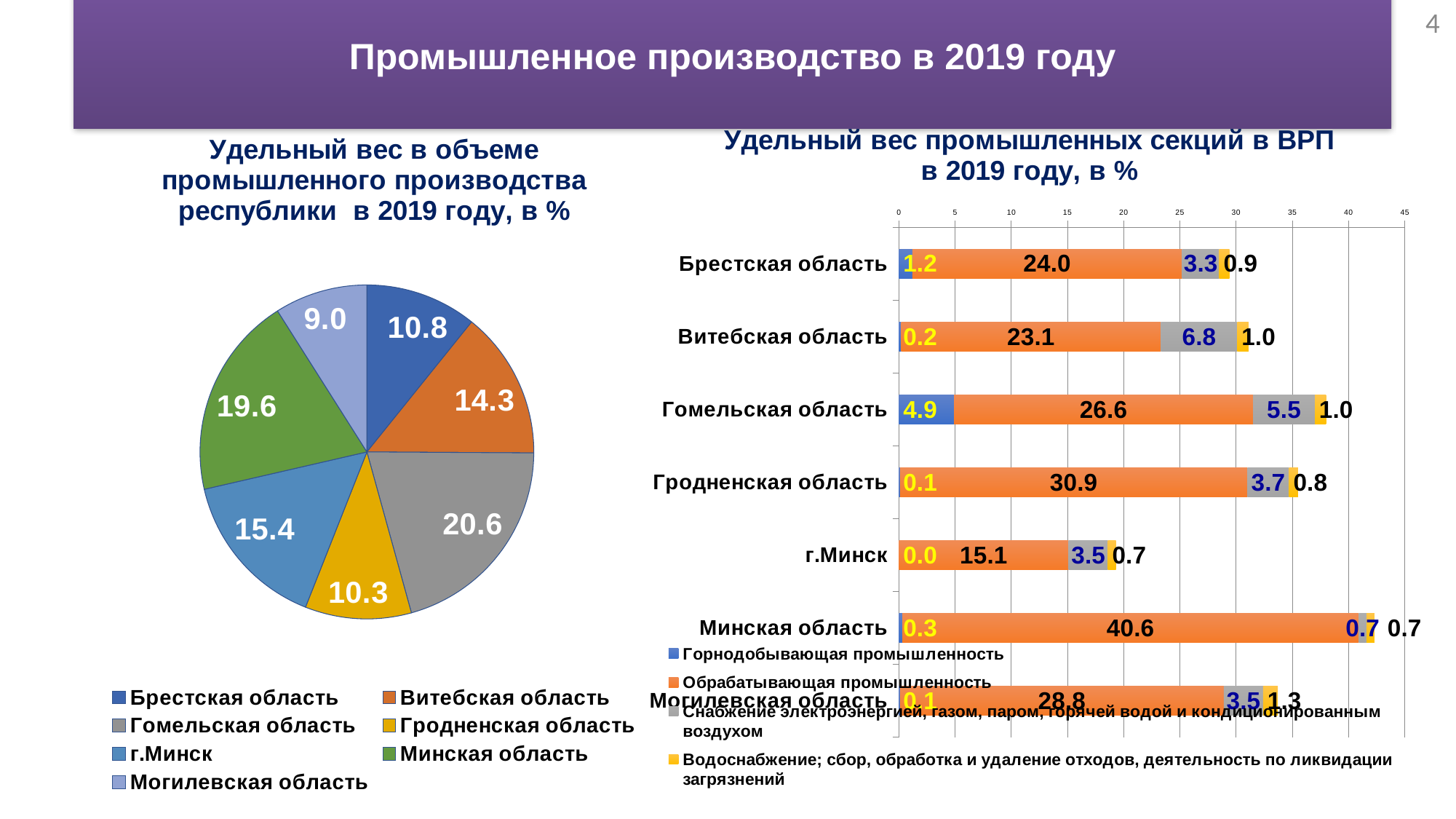
How many regions are shown in the pie chart on the left? 7 In the right chart "Удельный вес промышленных секций в ВРП в 2019 году, в %", what is the total of the stacked bar for Брестская область? 29.4 In the right chart "Удельный вес промышленных секций в ВРП в 2019 году, в %", which region has the highest value for Обрабатывающая промышленность? Минская область In the right chart "Удельный вес промышленных секций в ВРП в 2019 году, в %", what is the value of Горнодобывающая промышленность for Гомельская область? 4.9 In the right chart "Удельный вес промышленных секций в ВРП в 2019 году, в %", what is the value of Обрабатывающая промышленность for Гродненская область? 30.9 In the pie chart on the left, what is the value for Гомельская область? 20.6 What kind of chart is the left chart titled "Удельный вес в объеме промышленного производства республики в 2019 году, в %"? pie chart In the pie chart on the left, which region has the smallest share? Могилевская область How many series does the legend of the right chart "Удельный вес промышленных секций в ВРП в 2019 году, в %" list? 4 In the pie chart on the left, which is larger: the value for г.Минск or the value for Витебская область? г.Минск In the pie chart on the left, what is the difference between the values for Минская область and Брестская область? 8.8 In the pie chart on the left, which region has the largest share? Гомельская область